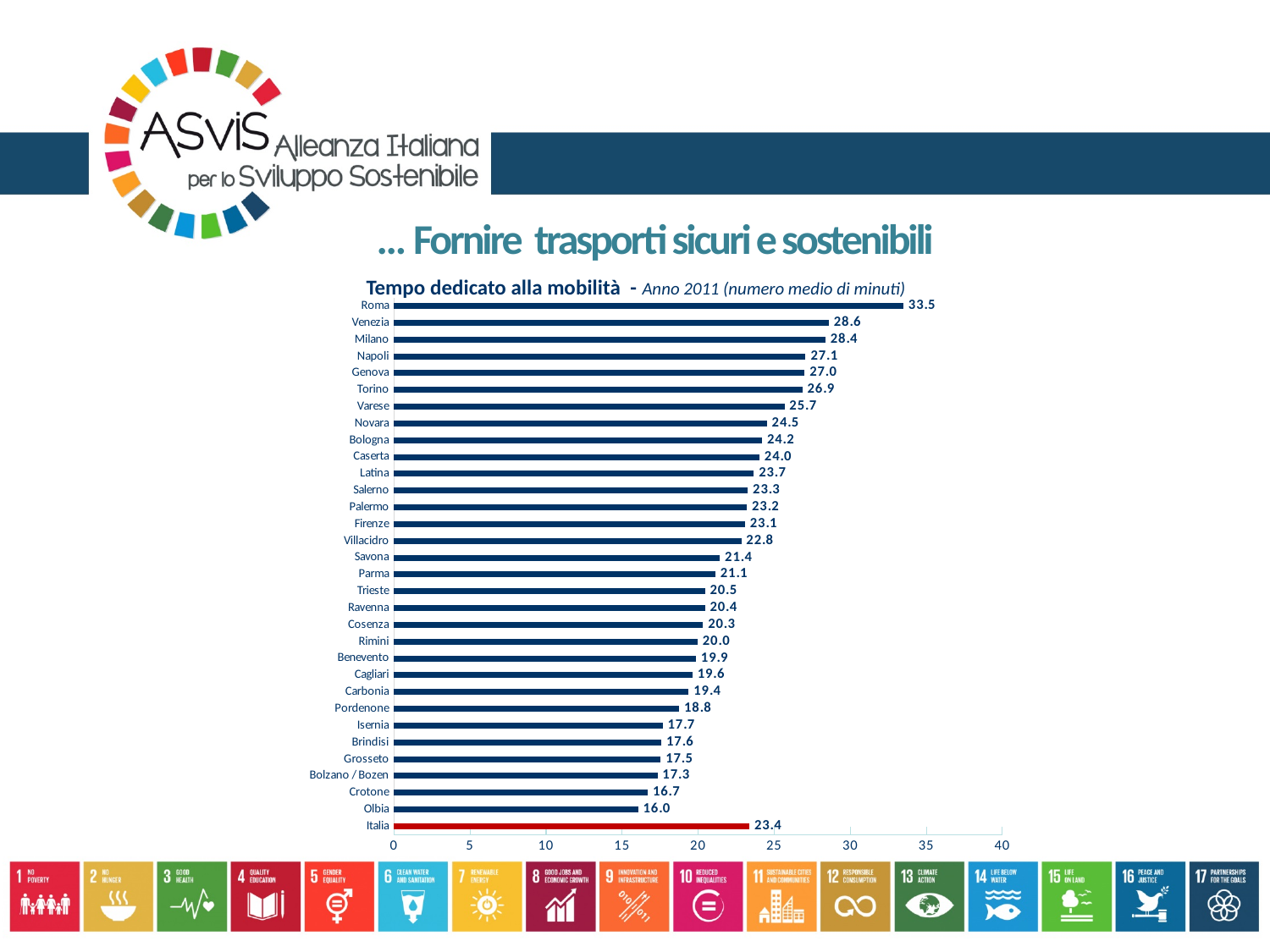
Which category has the lowest value? Olbia Which category has the highest value? Roma Which has a larger value, Venezia or Milano? Venezia What is the value for Olbia? 16.0 Is the value for Napoli greater or less than 25? greater What is the difference between the values for Roma and Italia? 10.1 What kind of chart is shown on the slide? bar chart What is the value for Italia? 23.4 What is the value for Roma? 33.5 Which bar is shown in a different colour (red) from the others? Italia What is the title of the chart? Tempo dedicato alla mobilità - Anno 2011 (numero medio di minuti) How many categories are plotted in the chart? 32